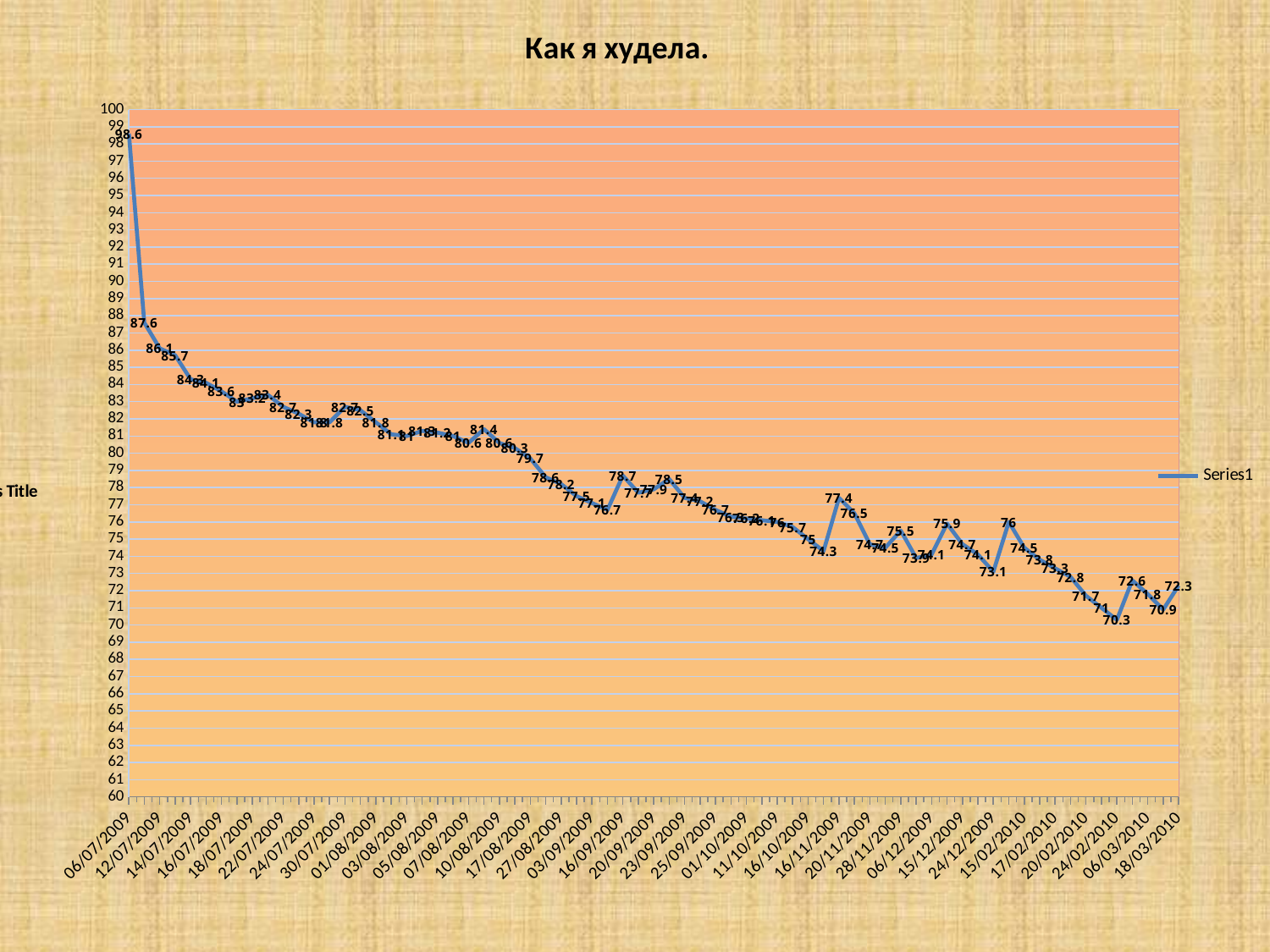
What is the lowest value plotted on the chart? 70.3 What is the value plotted for 18/03/2010? 72.3 How many series does the legend list? 1 What is the name of the series shown in the legend? Series1 Is the value for 18/03/2010 greater or less than 80? less What is the difference between the value for 06/07/2009 and the value for 18/03/2010? 26.3 Do the values generally rise or fall from left to right along the x axis? fall What is the title of the chart? Как я худела. What is the value plotted for 06/07/2009? 98.6 What is the highest value plotted on the chart? 98.6 Which has the larger value, 06/07/2009 or 18/03/2010? 06/07/2009 What kind of chart is shown on the slide? line chart